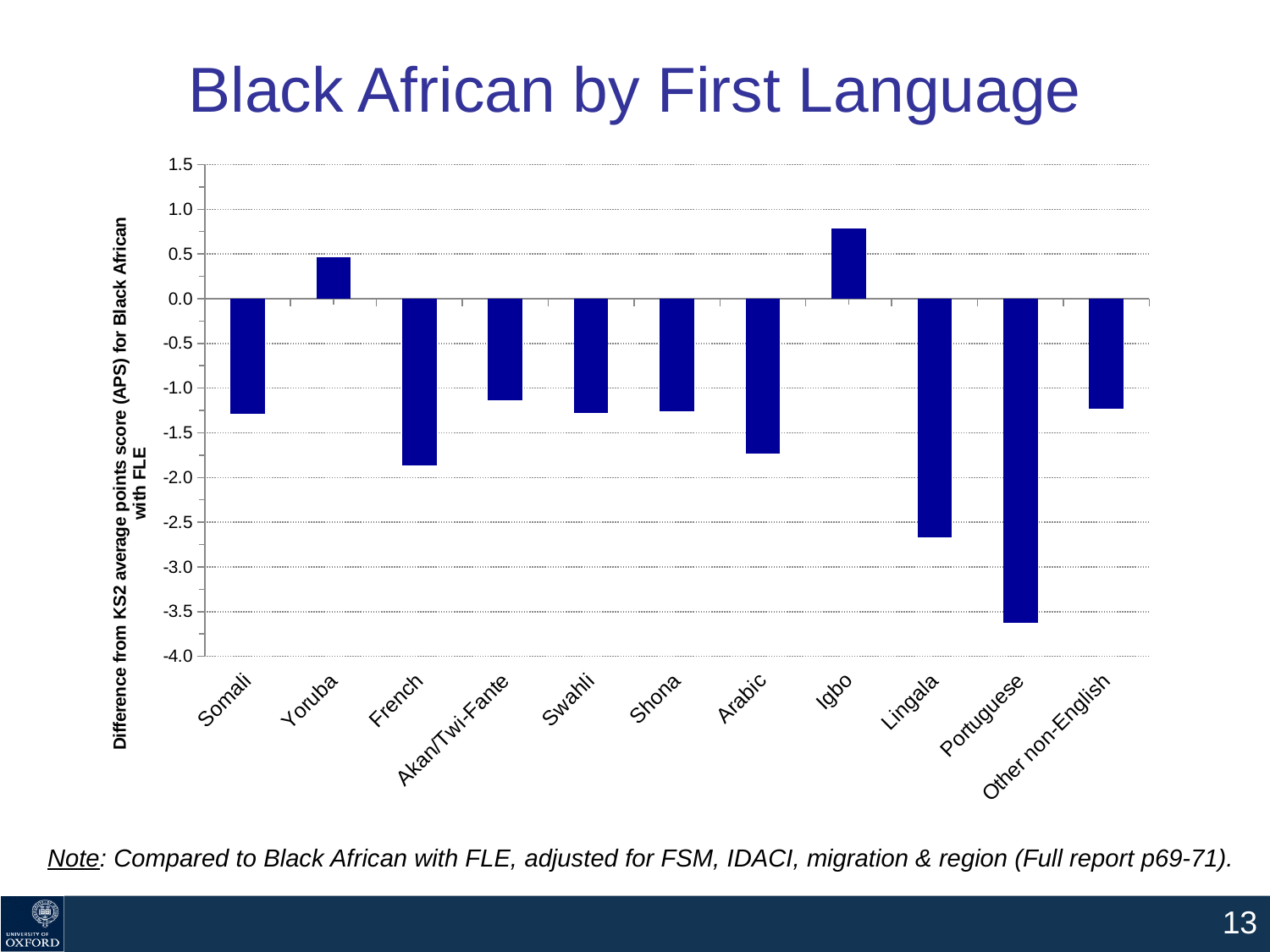
Is the value for Lingala greater or less than -2.5? less How many first-language categories are plotted on the chart? 11 Which has the lower value, French or Lingala? Lingala Which first-language category has the lowest value? Portuguese Is the value for Igbo greater or less than 0.5? greater Is the value for Arabic greater or less than -1.5? less What kind of chart is shown on the slide? bar chart Which first-language category has the highest value? Igbo How many first-language categories have a positive value? 2 What is the title of the chart? Black African by First Language Which has the larger value, Yoruba or Igbo? Igbo